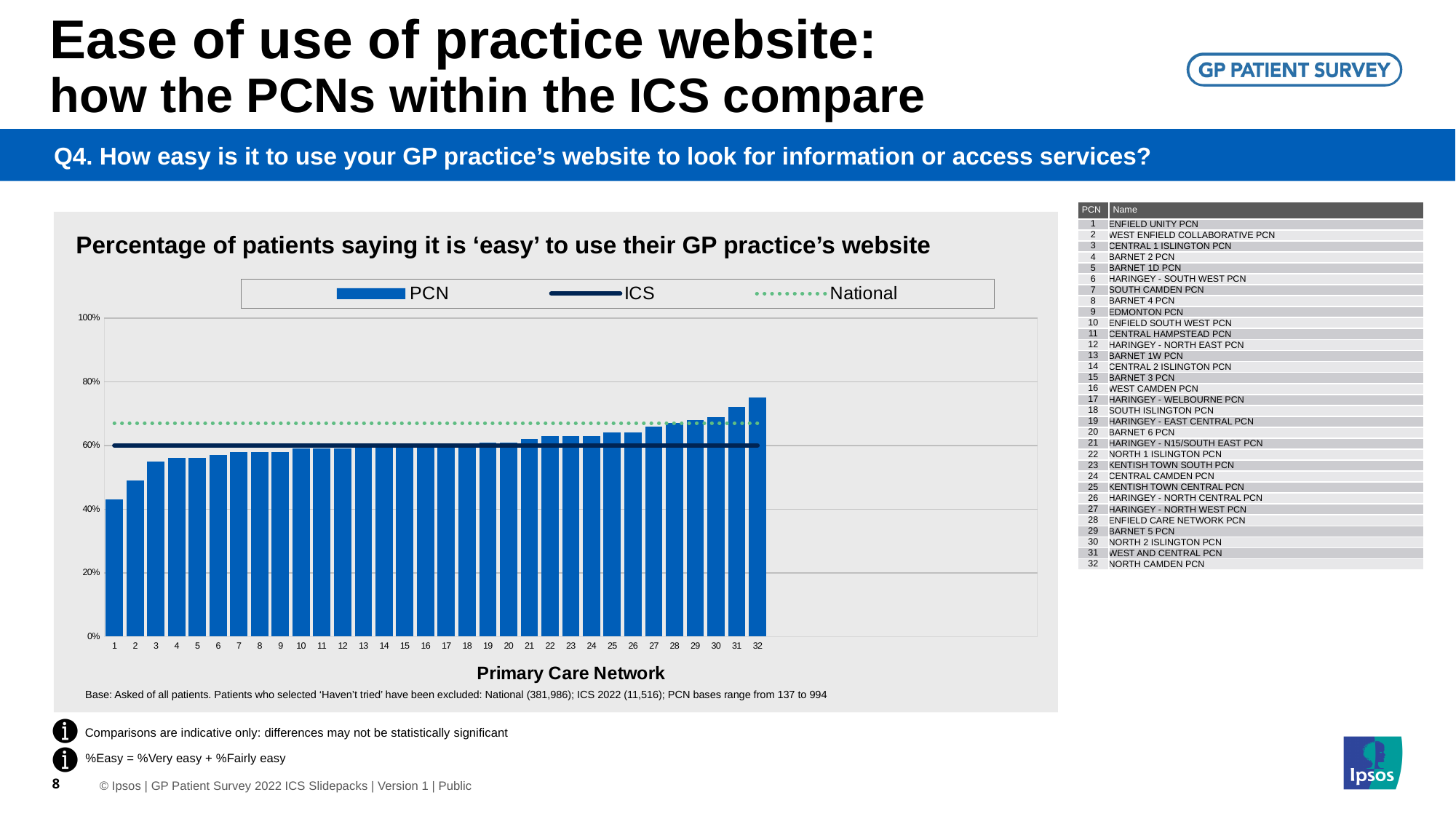
Do the bar values rise or fall as the PCN number increases along the x axis? rise Is the value for PCN 1 greater or less than 60%? less Which has the larger value, PCN 32 or PCN 1? PCN 32 Is the value for PCN 2 greater or less than 60%? less Which PCN number has the lowest percentage of patients saying it is 'easy' to use their GP practice's website? 1 How many Primary Care Networks (bars) are plotted on the chart? 32 Is the value for PCN 32 greater or less than 60%? greater How many series does the chart legend list? 3 Which PCN number has the highest percentage of patients saying it is 'easy' to use their GP practice's website? 32 What is the label of the x axis of the chart? Primary Care Network What kind of chart is shown on the slide? bar chart